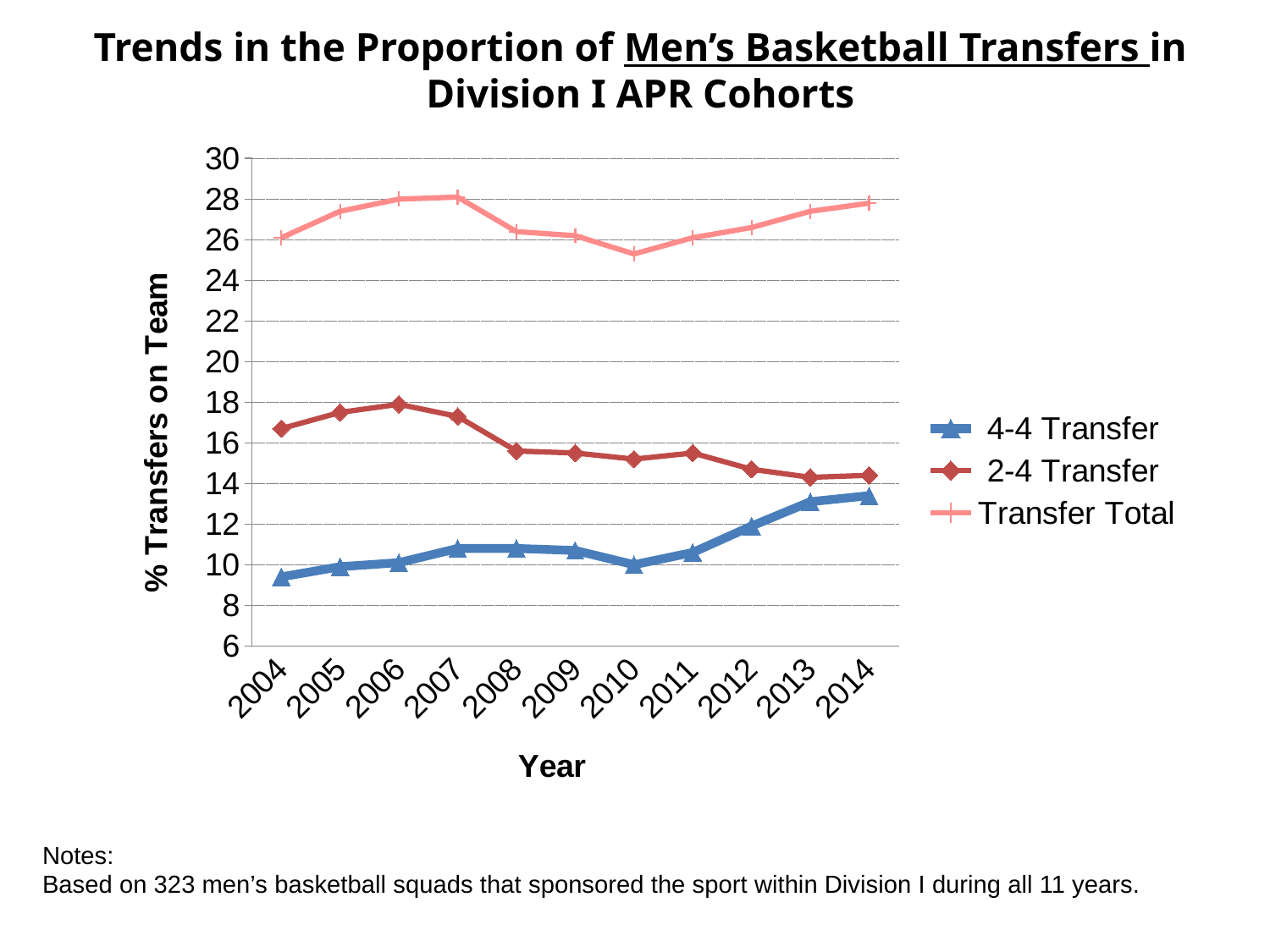
Is the value for 2-4 Transfer in 2013 greater or less than 16? less In which year is the Transfer Total series at its lowest? 2010 Is the value for 4-4 Transfer in 2004 greater or less than 10? less In which year is the 4-4 Transfer series at its lowest? 2004 Is the value for 4-4 Transfer in 2014 greater or less than 12? greater In 2004, which is larger: 2-4 Transfer or 4-4 Transfer? 2-4 Transfer What kind of chart is shown on the slide? Line chart How many series does the legend list? 3 In which year is the 2-4 Transfer series at its highest? 2006 Does the 4-4 Transfer series rise or fall from 2010 to 2014? Rise How many years are plotted along the x axis? 11